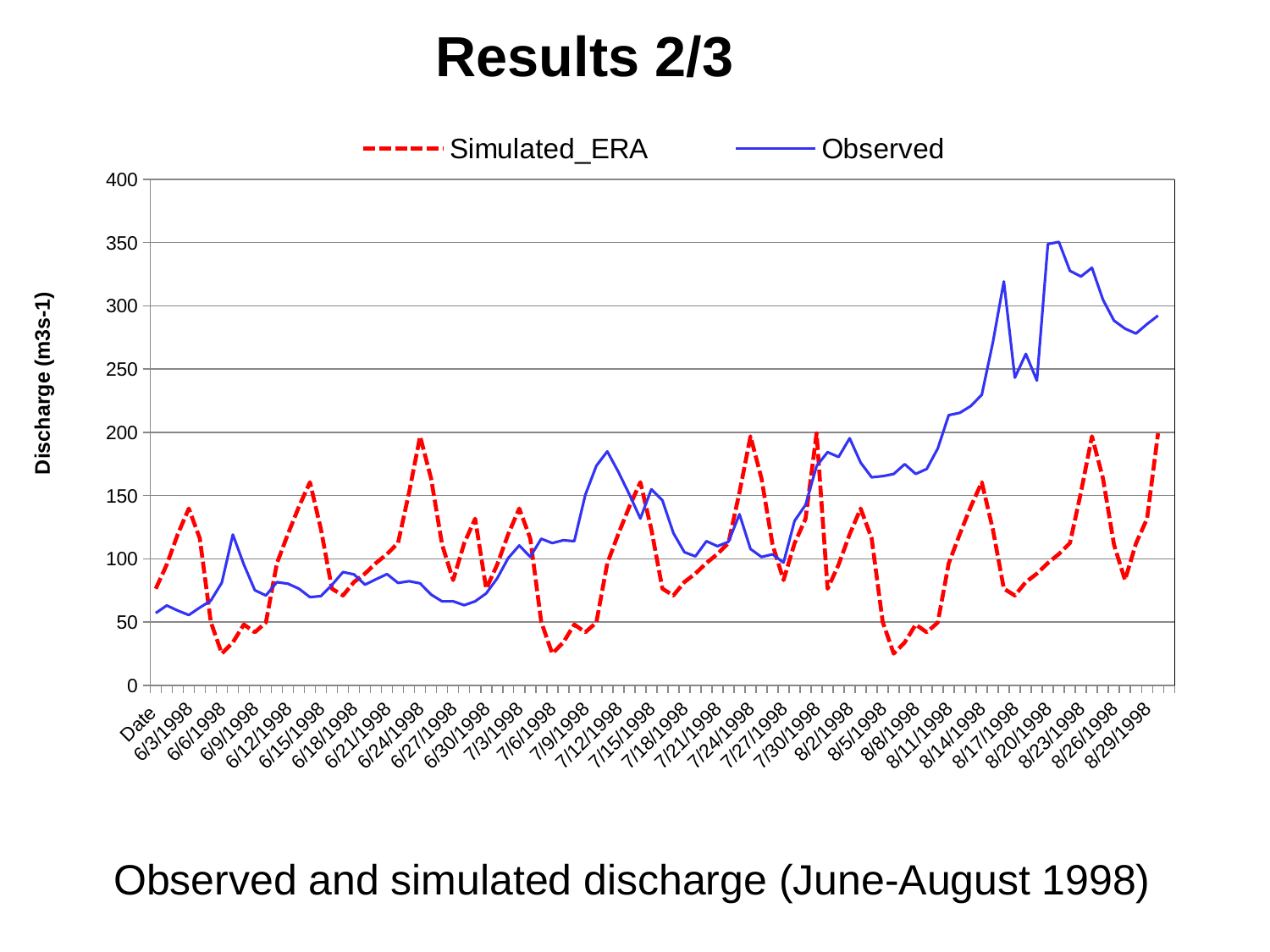
How many series does the legend list? 2 What is the label of the vertical axis? Discharge (m3s-1) Is the Observed value at 8/20/1998 greater or less than 300? greater Is the Observed value at 8/5/1998 greater or less than 150? greater At 6/24/1998, which series has the larger value, Simulated_ERA or Observed? Simulated_ERA Is the Simulated_ERA value at 6/24/1998 greater or less than 150? greater At 8/20/1998, which series has the larger value, Simulated_ERA or Observed? Observed What kind of chart is shown on the slide? Line chart What are the two series named in the legend? Simulated_ERA and Observed Does the Observed series generally rise or fall from June to the end of August 1998? Rise